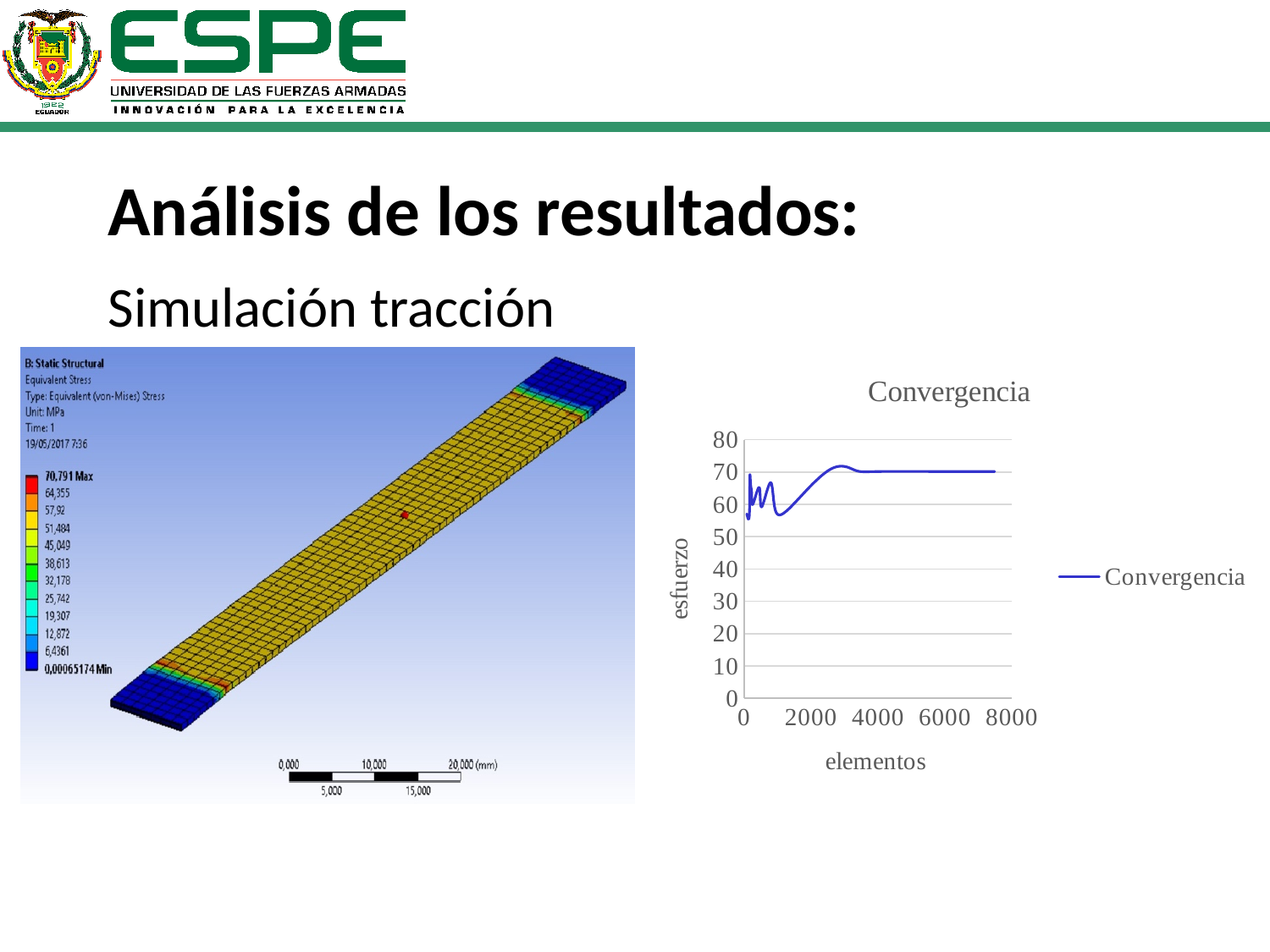
In the Convergencia chart, is the value at 2000 elementos greater or less than 50? greater In the Convergencia chart, is the value at 1000 elementos greater or less than 70? less In the Convergencia chart, does the line rise or stay flat between 4000 and 8000 elementos? stays flat What is the highest tick value shown on the y axis of the Convergencia chart? 80 What kind of chart is the Convergencia chart? line chart In the Convergencia chart, is the value at 4000 elementos greater or less than 80? less What is the title of the chart on the right of the slide? Convergencia How many series does the legend of the Convergencia chart list? 1 In the Convergencia chart, does the line end higher or lower than where it starts at 0 elementos? higher What is the label on the x axis of the Convergencia chart? elementos